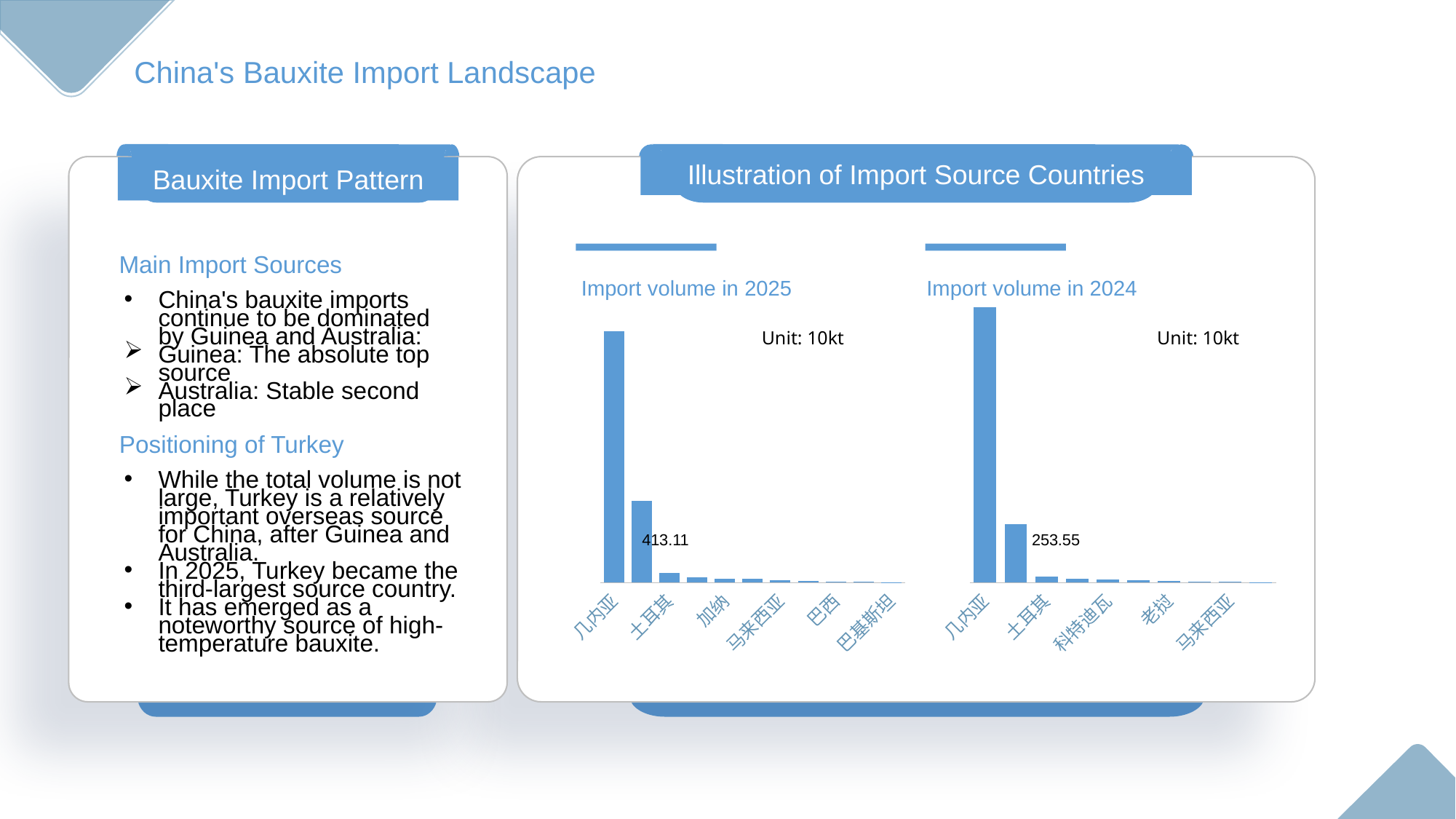
What unit is shown on the "Import volume in 2025" chart? 10kt In the "Import volume in 2024" chart, do the values rise or fall from left to right along the x axis? Fall In the "Import volume in 2025" chart, which is larger, the bar for 土耳其 or the bar for 加纳? 土耳其 In the "Import volume in 2025" chart, what is the labelled value for 土耳其? 413.11 What type of chart is the "Import volume in 2025" chart? Bar chart Comparing the two charts, is the labelled value for 土耳其 larger in 2025 or in 2024? 2025 In the "Import volume in 2024" chart, which is larger, the bar for 几内亚 or the bar for 土耳其? 几内亚 In the "Import volume in 2025" chart, which country has the highest import volume? 几内亚 In the "Import volume in 2024" chart, which country has the highest import volume? 几内亚 In the "Import volume in 2024" chart, what is the labelled value for 土耳其? 253.55 What is the title of the panel containing the two charts? Illustration of Import Source Countries What is the difference between the labelled value for 土耳其 in the 2025 chart and in the 2024 chart? 159.56